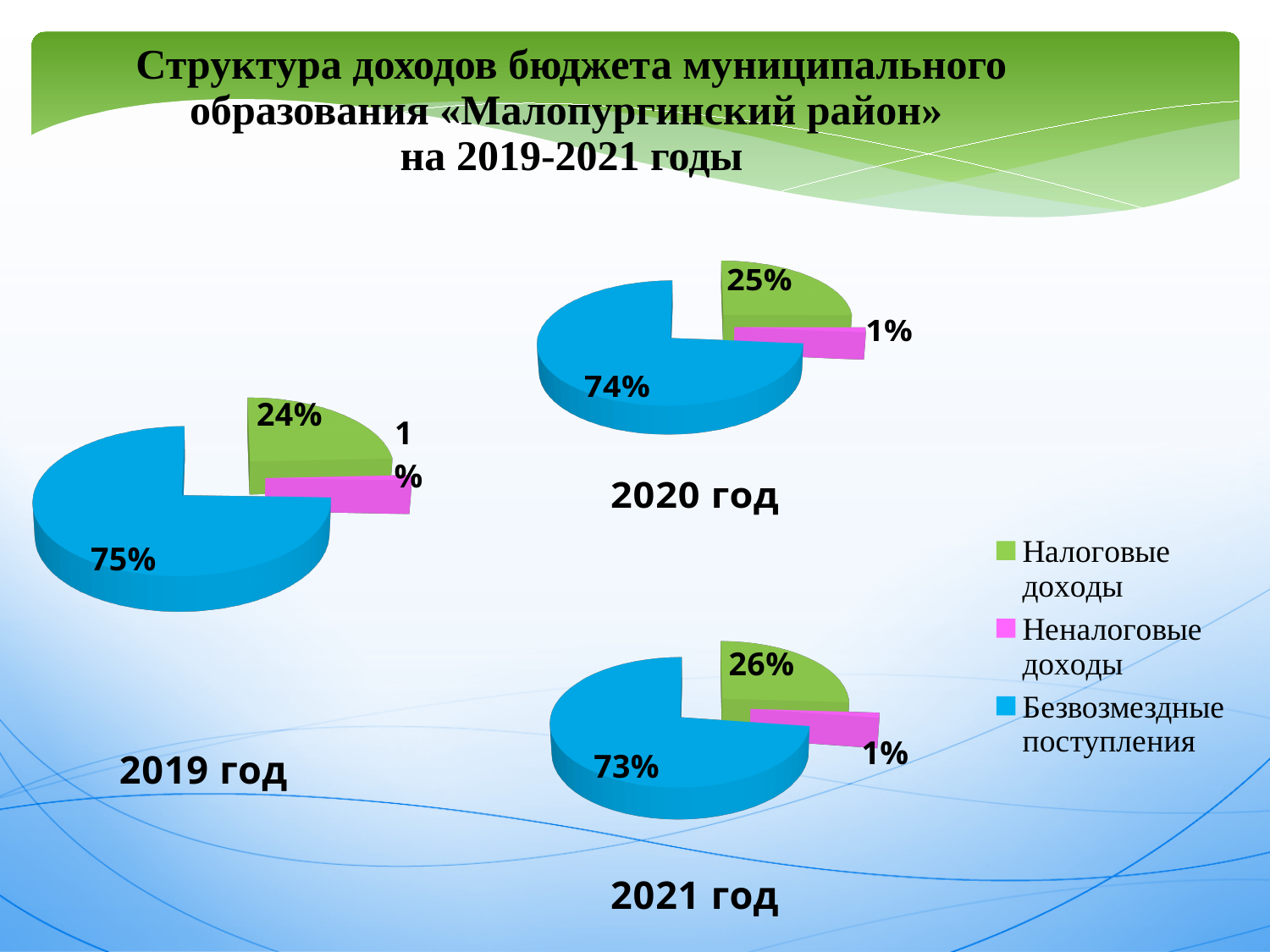
In the 2020 год pie chart, which category has the largest share? Безвозмездные поступления How many pie charts are shown on the slide? 3 In the 2019 год pie chart, what share is shown for Безвозмездные поступления? 75% How many categories does the legend list? 3 In the 2021 год pie chart, what share is shown for Неналоговые доходы? 1% Which colour represents Неналоговые доходы in the legend? Pink What type of chart is used for the 2019 год data? Pie chart In the 2021 год pie chart, what share is shown for Безвозмездные поступления? 73% In the 2021 год pie chart, what is the difference between the shares of Безвозмездные поступления and Налоговые доходы? 47% In the 2019 год pie chart, which category has the smallest share? Неналоговые доходы In the 2020 год pie chart, what share is shown for Налоговые доходы? 25% Which is larger in the 2020 год pie chart: the share of Налоговые доходы or the share of Неналоговые доходы? Налоговые доходы